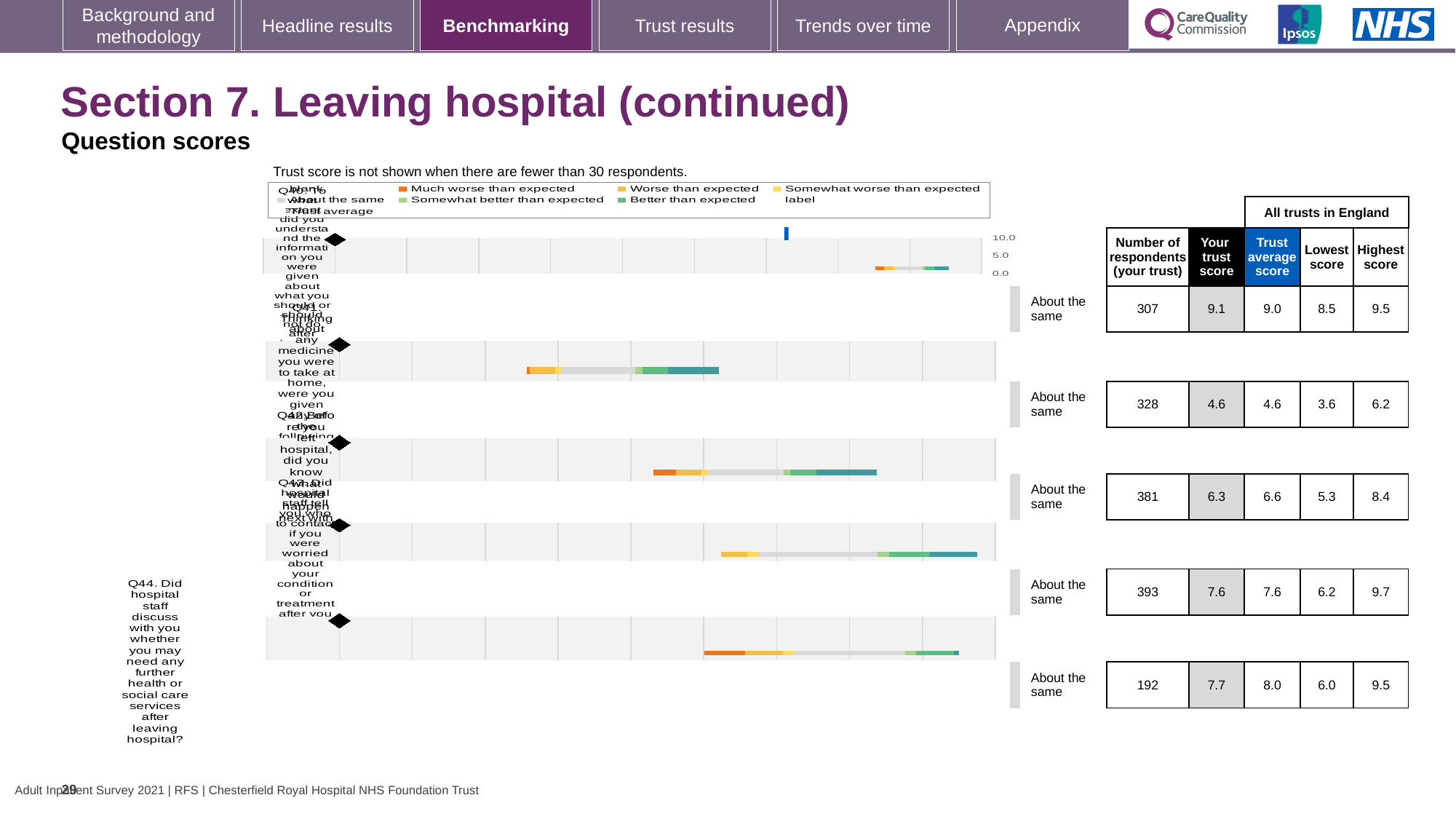
What is the trust average score for Q44 (the last row of the table)? 8.0 What benchmark category is shown for every question row on the slide? About the same What is the trust's score for Q44 (the last row of the table)? 7.7 What is the difference between the highest score and the lowest score for the third row of the table? 3.1 How many question rows are plotted in the chart? 5 Which row of the table has the lowest 'Your trust score'? the second row (4.6) Which row of the table has the highest number of respondents? the fourth row (393) What is the lowest score among all trusts in England for the second row of the table? 3.6 What is the number of respondents for Q44 (the last row of the table)? 192 What kind of chart is shown on the slide? bar chart Is the trust's score for the first row of the table larger or smaller than the trust average score? larger What is the highest score among all trusts in England for the first row of the table? 9.5